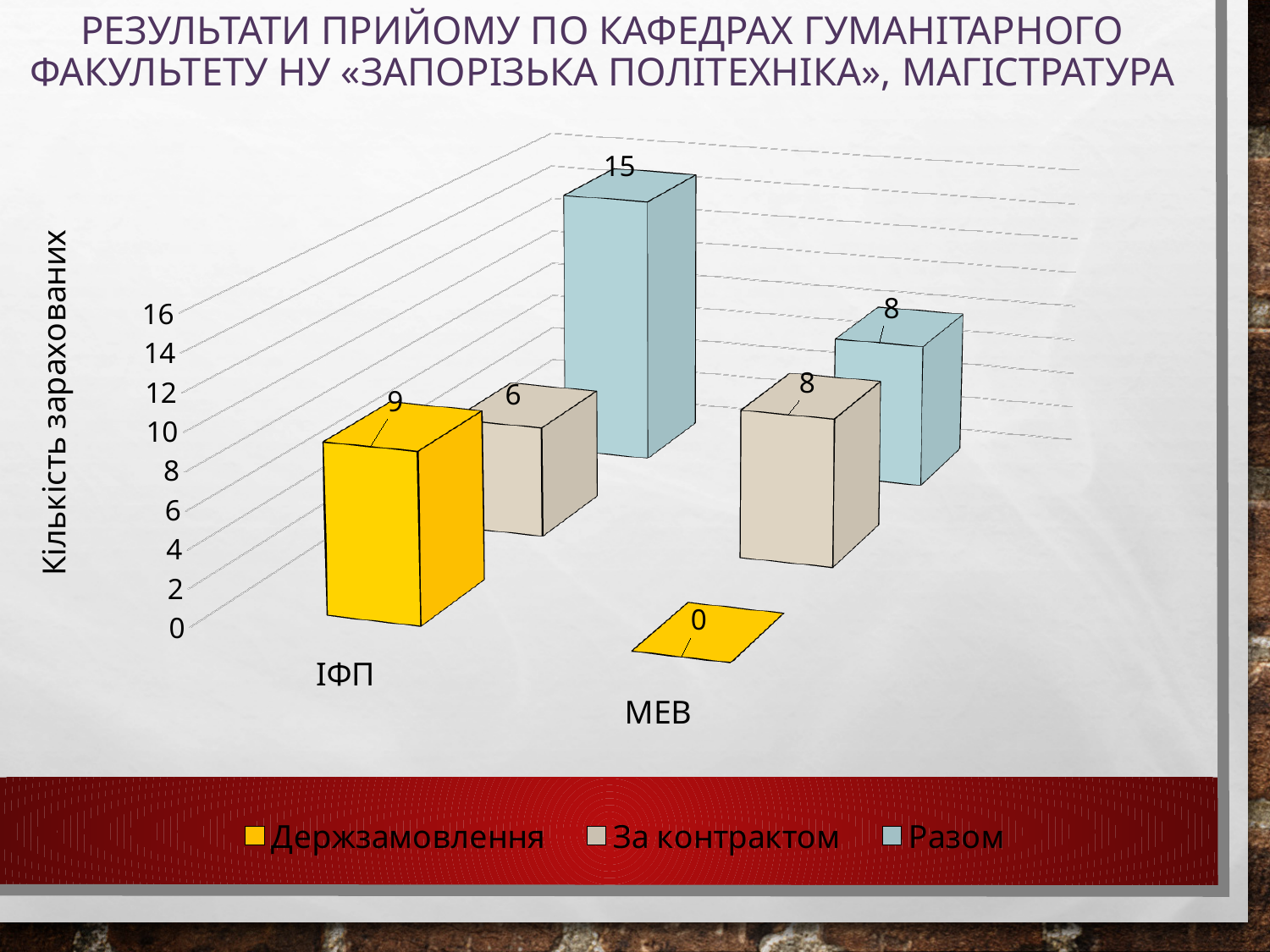
What kind of chart is shown on the slide? Bar chart What is the value of За контрактом for МЕВ? 8 Which is larger: За контрактом for ІФП or За контрактом for МЕВ? МЕВ What is the value of Держзамовлення for ІФП? 9 Which category has the lowest Держзамовлення value? МЕВ What is the difference between the Разом values for ІФП and МЕВ? 7 How many categories are shown on the x axis? 2 What is the value of За контрактом for ІФП? 6 How many series does the legend list? 3 What is the value of Держзамовлення for МЕВ? 0 What is the value of Разом for ІФП? 15 Which category has the highest Разом value? ІФП